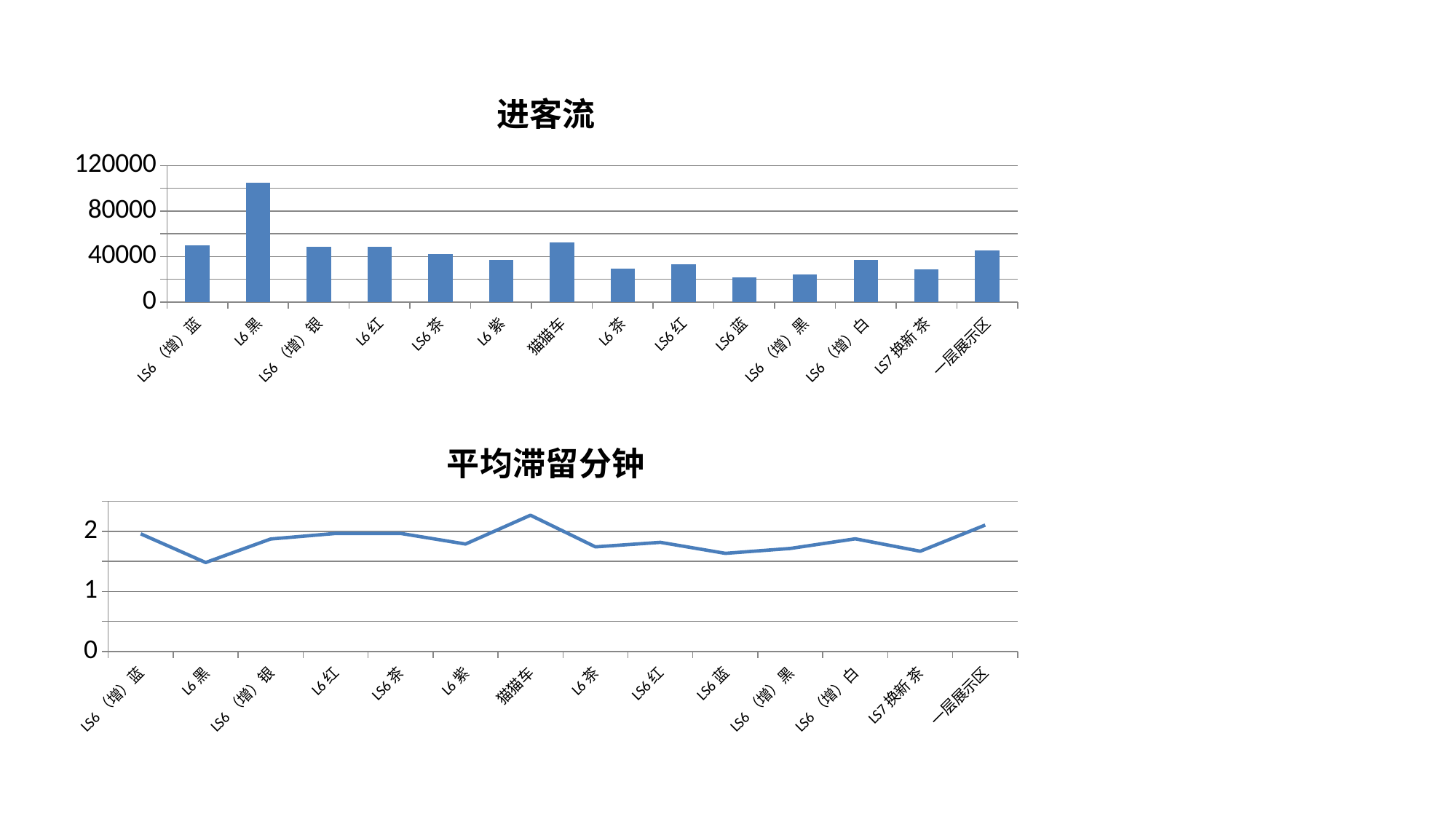
In the "平均滞留分钟" chart, is the value for L6 黑 greater or less than 2? less In the "平均滞留分钟" chart, which category has the lowest value? L6 黑 What type of chart is the "平均滞留分钟" chart? line chart In the "进客流" chart, is the value for L6 黑 greater or less than 80000? greater In the "进客流" chart, is the value for LS6 蓝 greater or less than 40000? less In the "进客流" chart, which category has the highest value? L6 黑 What type of chart is the "进客流" chart? bar chart In the "平均滞留分钟" chart, which category has the highest value? 猫猫车 In the "进客流" chart, which is larger, the value for 猫猫车 or the value for L6 茶? 猫猫车 How many categories are shown on the x axis of the "进客流" chart? 14